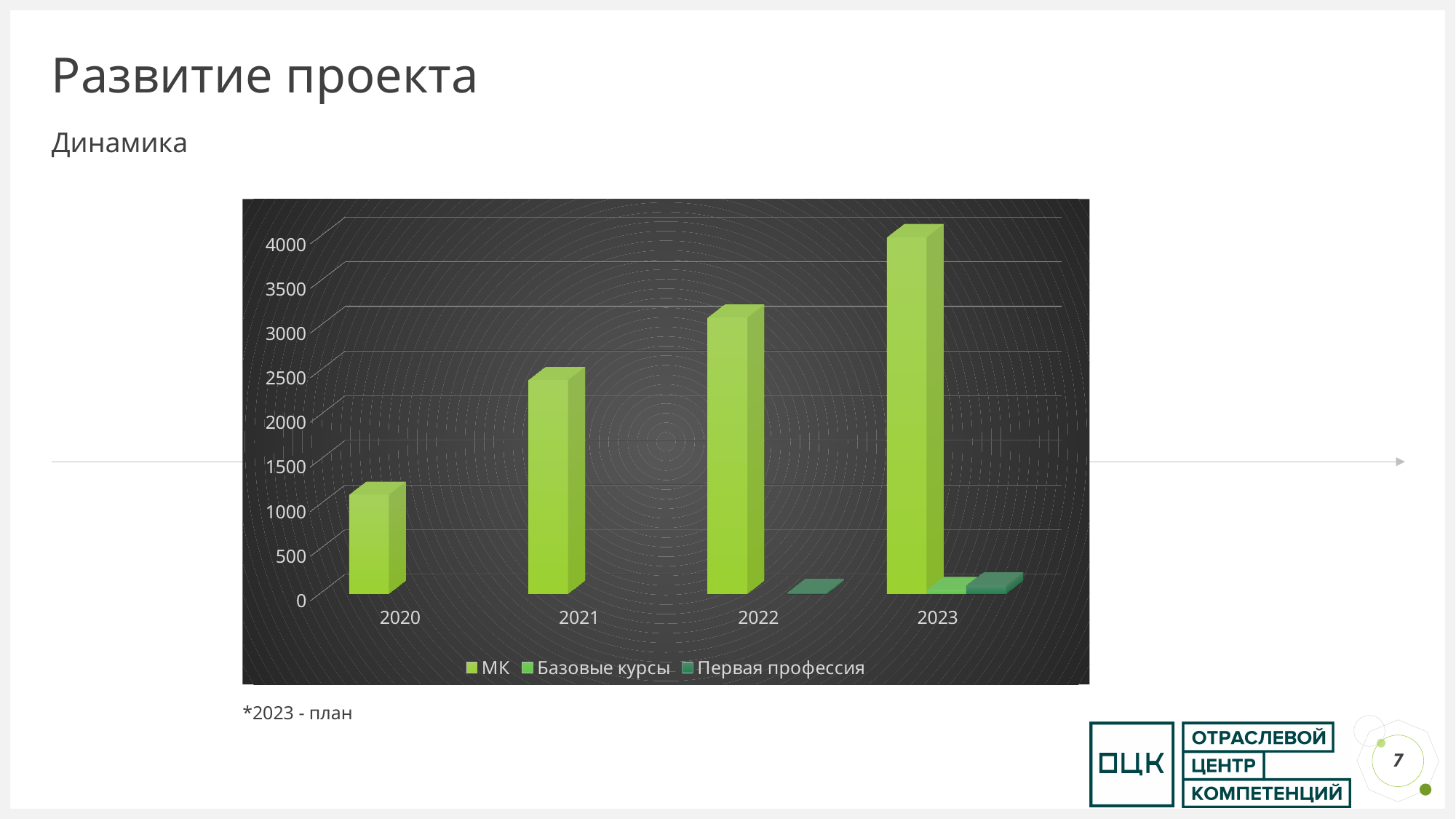
What kind of chart is shown on the slide? bar chart Which is larger, the МК value for 2021 or for 2020? 2021 In which year is the МК value lowest? 2020 How many years are shown on the x axis? 4 How many series does the legend list? 3 What are the three series named in the legend? МК, Базовые курсы, Первая профессия Is the МК value for 2022 greater or less than 2500? greater Do the МК values rise or fall from 2020 to 2023? rise Is the МК value for 2023 greater or less than 3500? greater Is the МК value for 2021 greater or less than 2000? greater In which year is the МК value highest? 2023